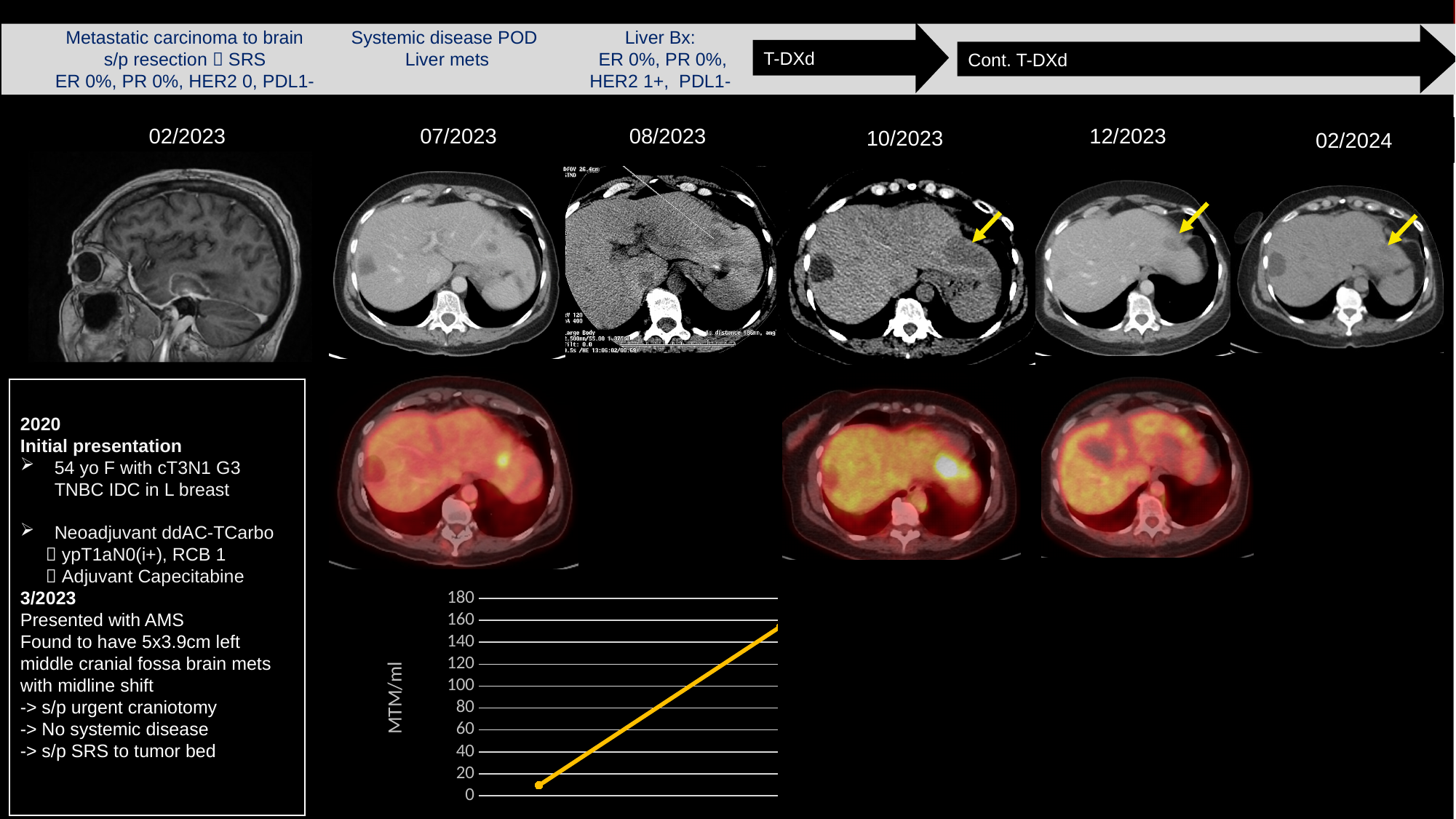
What kind of chart is shown at the bottom of the slide? line chart Which end of the line in the chart has the higher value, the left end or the right end? right end What is the label on the y axis of the line chart? MTM/ml Do the values in the line chart rise or fall from left to right? rise Is the value at the right end of the line in the chart greater or less than 140? greater Is the value at the right end of the line in the chart greater or less than 160? less Is the value at the left end of the line in the chart greater or less than 20? less What is the highest tick value shown on the y axis of the line chart? 180